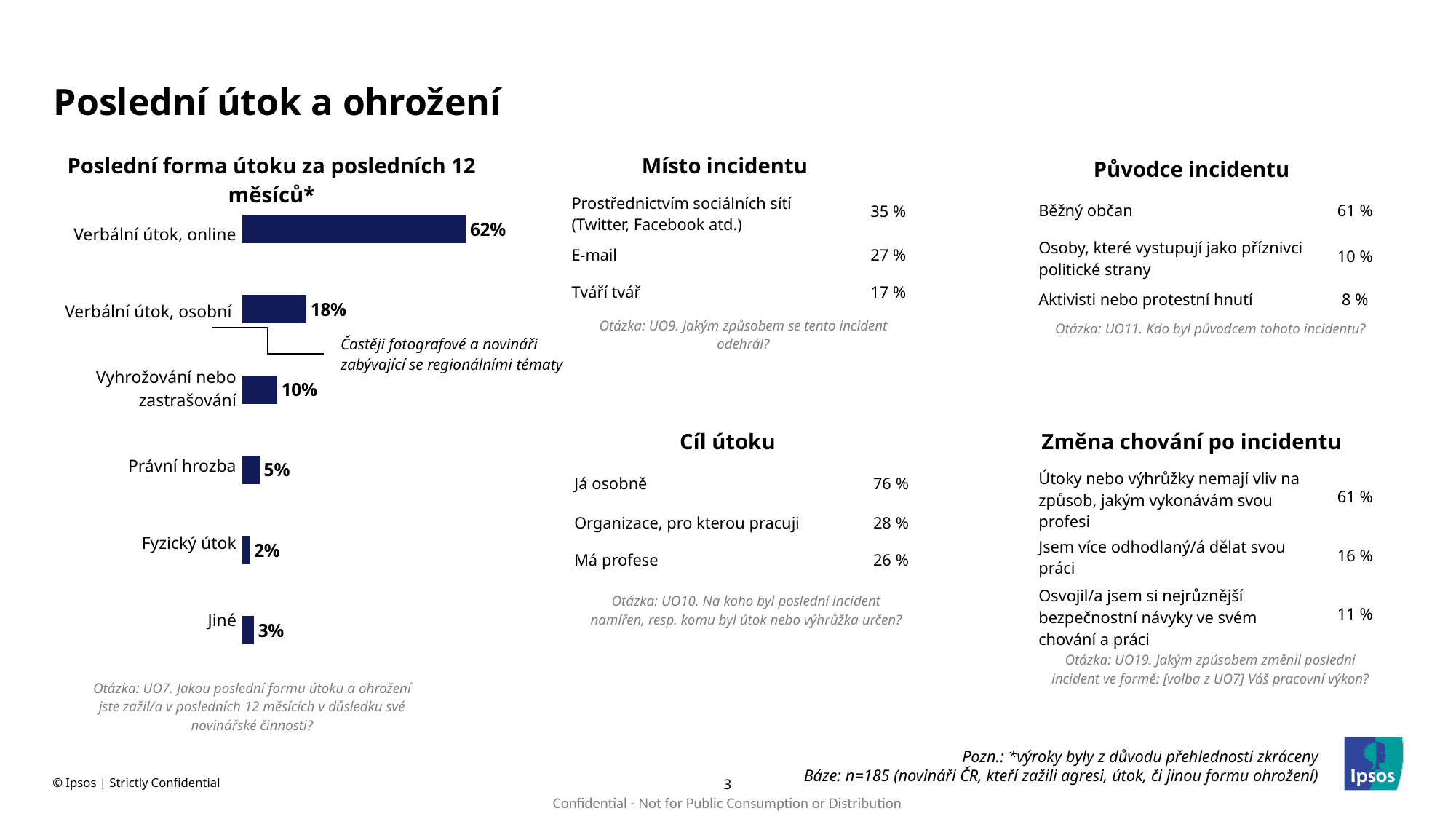
In the chart 'Poslední forma útoku za posledních 12 měsíců*', what is the difference between 'Verbální útok, osobní' and 'Vyhrožování nebo zastrašování'? 8% In the chart 'Poslední forma útoku za posledních 12 měsíců*', which category has the highest value? Verbální útok, online In the chart 'Poslední forma útoku za posledních 12 měsíců*', what is the difference between 'Verbální útok, online' and 'Verbální útok, osobní'? 44% What annotation is attached to the 'Verbální útok, osobní' bar in the chart 'Poslední forma útoku za posledních 12 měsíců*'? Častěji fotografové a novináři zabývající se regionálními tématy In the chart 'Poslední forma útoku za posledních 12 měsíců*', what is the value for 'Jiné'? 3% In the chart 'Poslední forma útoku za posledních 12 měsíců*', which category has the lowest value? Fyzický útok How many categories are shown in the chart 'Poslední forma útoku za posledních 12 měsíců*'? 6 In the chart 'Poslední forma útoku za posledních 12 měsíců*', what is the value for 'Fyzický útok'? 2% In the chart 'Poslední forma útoku za posledních 12 měsíců*', which is larger: 'Právní hrozba' or 'Jiné'? Právní hrozba In the chart 'Poslední forma útoku za posledních 12 měsíců*', what is the value for 'Verbální útok, online'? 62% What kind of chart is 'Poslední forma útoku za posledních 12 měsíců*'? Bar chart In the chart 'Poslední forma útoku za posledních 12 měsíců*', what is the value for 'Vyhrožování nebo zastrašování'? 10%